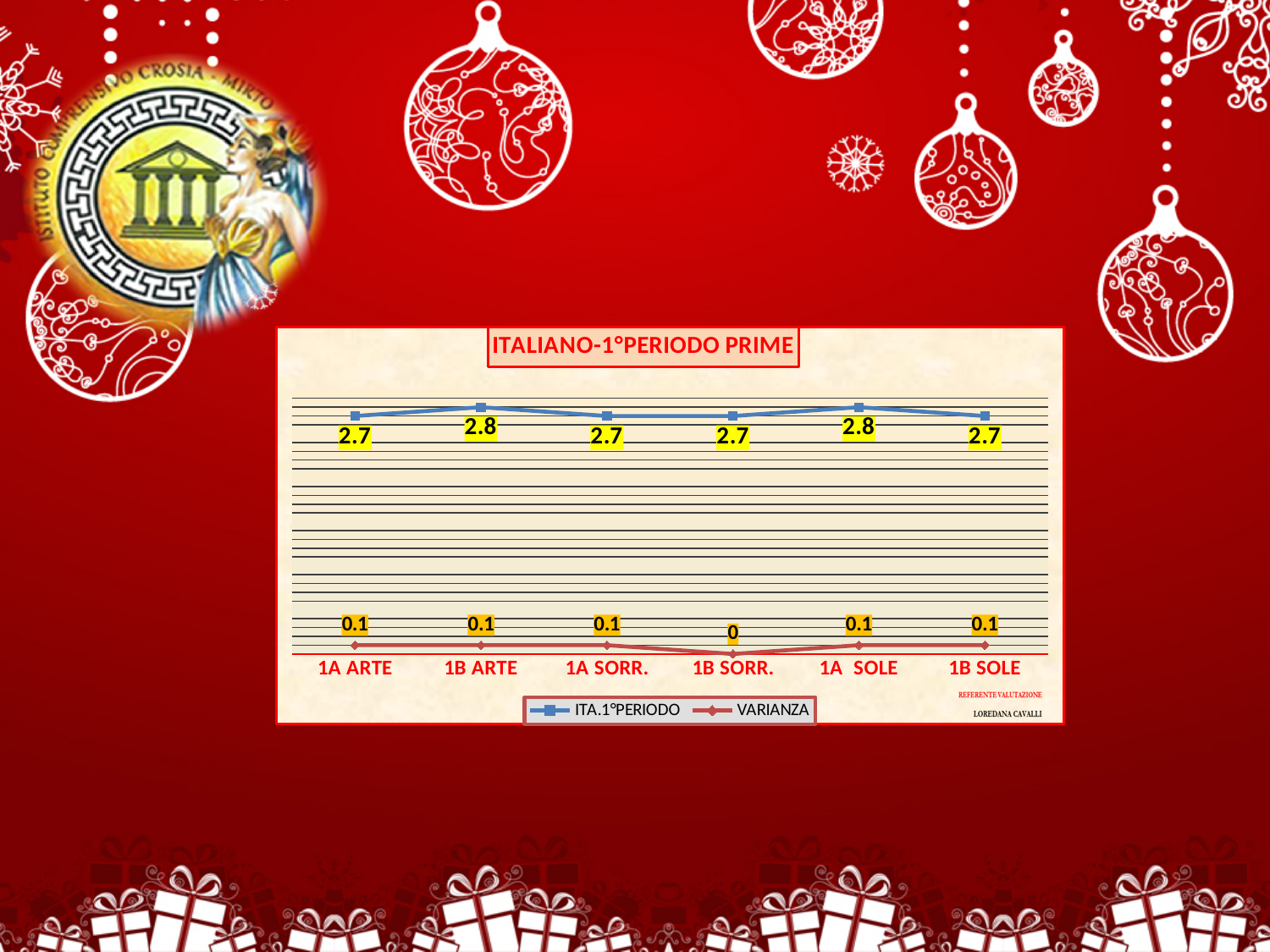
What is the difference between the ITA.1°PERIODO values for 1B ARTE and 1A ARTE? 0.1 What is the ITA.1°PERIODO value for 1A SORR.? 2.7 What is the title of the chart? ITALIANO-1°PERIODO PRIME How many categories are shown on the x axis? 6 How many series does the legend list? 2 What is the VARIANZA value for 1B SORR.? 0 Which is larger, the ITA.1°PERIODO value for 1A SOLE or for 1B SOLE? 1A SOLE What is the VARIANZA value for 1A SOLE? 0.1 Which category has the lowest VARIANZA value? 1B SORR. What is the ITA.1°PERIODO value for 1B ARTE? 2.8 What kind of chart is shown on the slide? line chart What are the two series names listed in the legend? ITA.1°PERIODO and VARIANZA